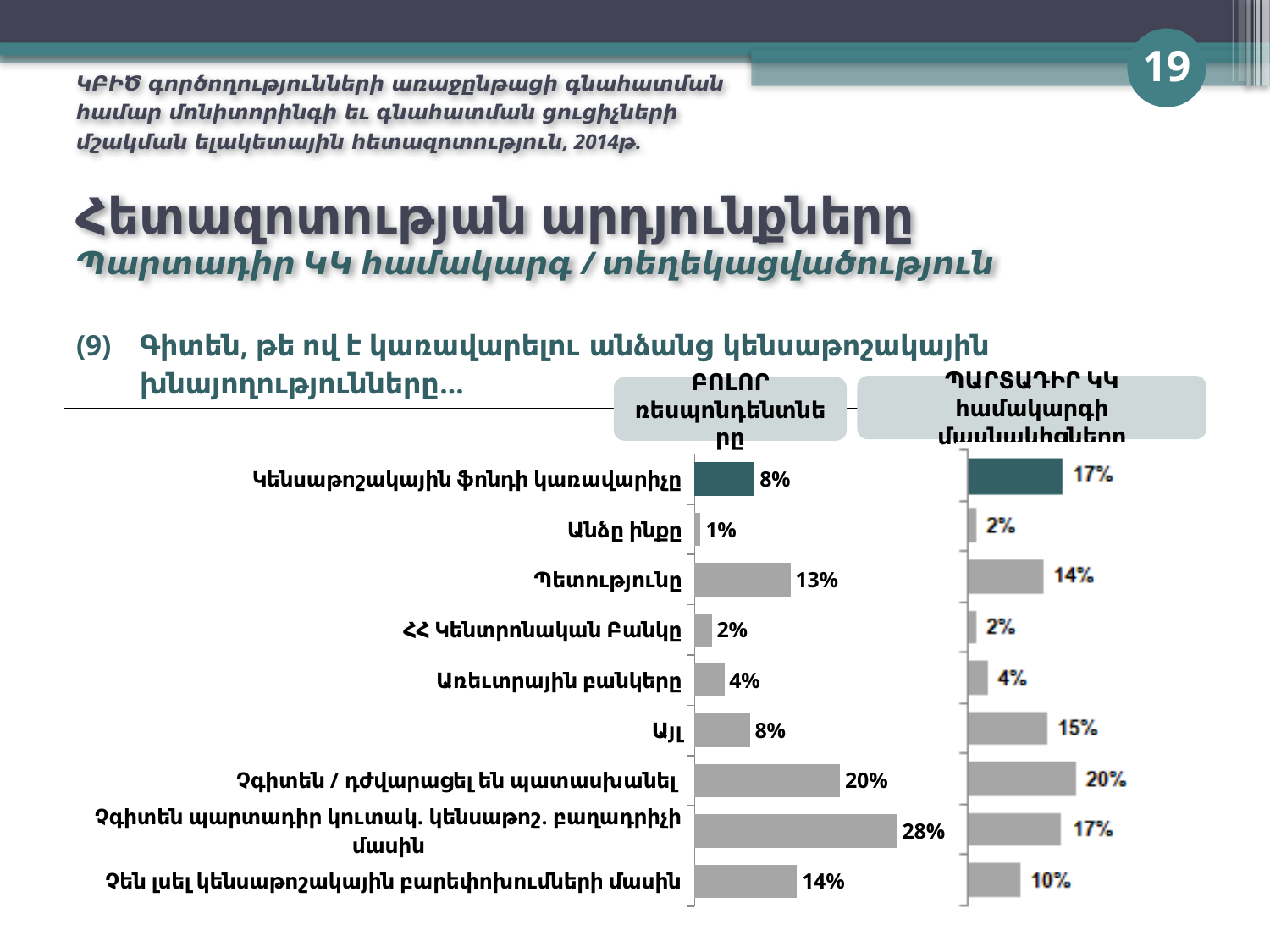
What type of chart is used on this slide? Bar chart In the left chart (ԲՈԼՈՐ ռեսպոնդենտները), what is the value for Պետությունը? 13% In the left chart (ԲՈԼՈՐ ռեսպոնդենտները), what is the difference between Չգիտեն պարտադիր կուտակ. կենսաթոշ. բաղադրիչի մասին and Չեն լսել կենսաթոշակային բարեփոխումների մասին? 14% In the left chart (ԲՈԼՈՐ ռեսպոնդենտները), which category has the highest value? Չգիտեն պարտադիր կուտակ. կենսաթոշ. բաղադրիչի մասին In the right chart (ՊԱՐՏԱԴԻՐ ԿԿ համակարգի մասնակիցները), which is larger: Պետությունը or Չեն լսել կենսաթոշակային բարեփոխումների մասին? Պետությունը In the right chart (ՊԱՐՏԱԴԻՐ ԿԿ համակարգի մասնակիցները), what is the value for Այլ? 15% In the right chart (ՊԱՐՏԱԴԻՐ ԿԿ համակարգի մասնակիցները), which category has the highest value? Չգիտեն / դժվարացել են պատասխանել In the left chart (ԲՈԼՈՐ ռեսպոնդենտները), which category has the lowest value? Անձը ինքը In the left chart (ԲՈԼՈՐ ռեսպոնդենտները), what is the value for Առևտրային բանկերը? 4% How many categories are shown in the left chart (ԲՈԼՈՐ ռեսպոնդենտները)? 9 What is the difference between the value for Կենսաթոշակային ֆոնդի կառավարիչը in the right chart (ՊԱՐՏԱԴԻՐ ԿԿ համակարգի մասնակիցները) and in the left chart (ԲՈԼՈՐ ռեսպոնդենտները)? 9% In the right chart (ՊԱՐՏԱԴԻՐ ԿԿ համակարգի մասնակիցները), what is the value for Կենսաթոշակային ֆոնդի կառավարիչը? 17%